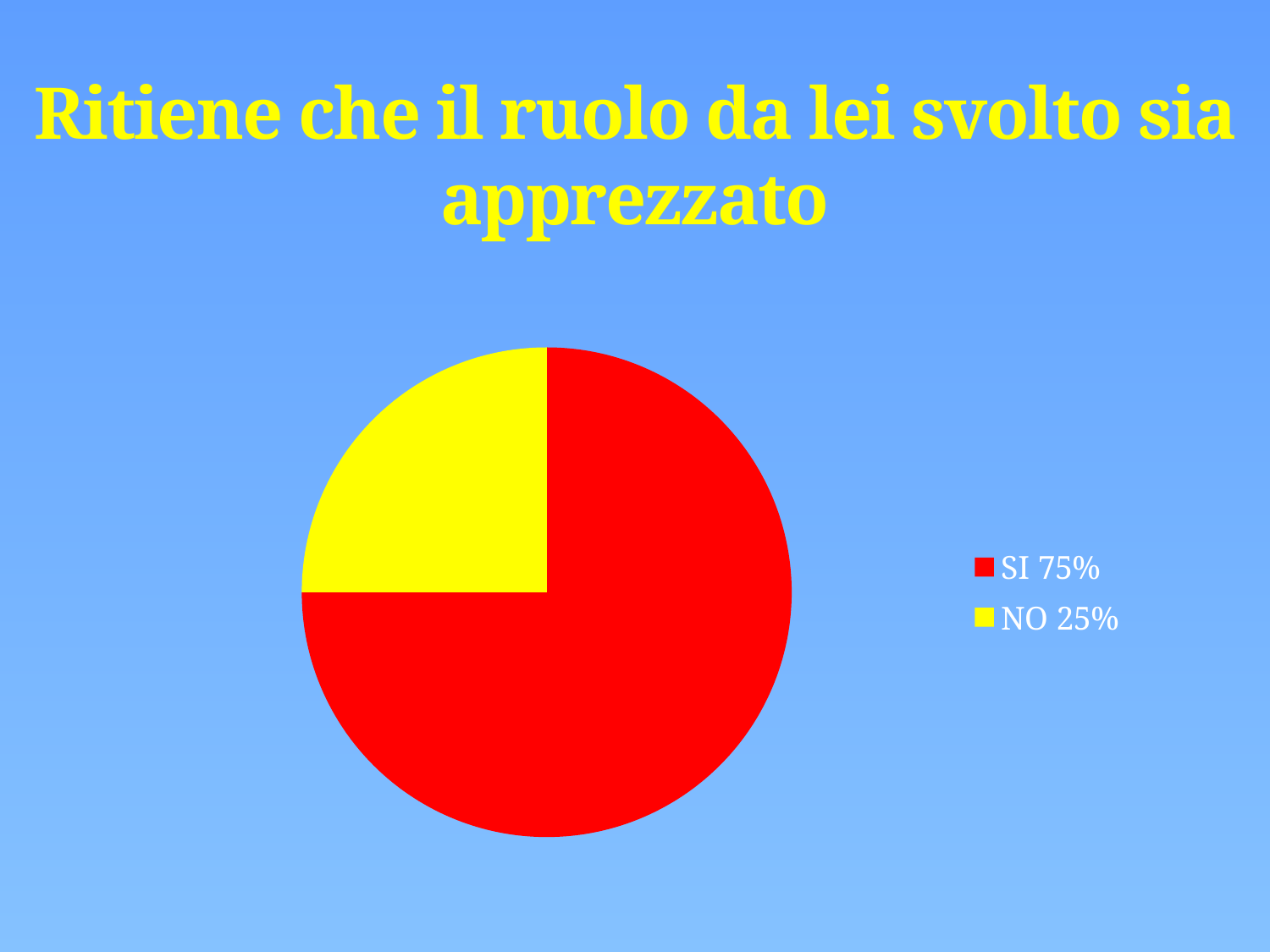
How many entries does the legend list? 2 What is the difference in percentage points between the SI and NO slices? 50 What kind of chart is shown on the slide? pie chart What share of the pie does the SI slice represent? 75% Is the value for SI greater or less than 50%? greater What share of the pie does the NO slice represent? 25% What is the title of the slide containing the chart? Ritiene che il ruolo da lei svolto sia apprezzato Which category has the largest slice of the pie? SI Which category has the smallest slice of the pie? NO What colour is the SI slice in the pie chart? red Which is larger, the SI slice or the NO slice? SI How many categories are shown in the pie chart? 2